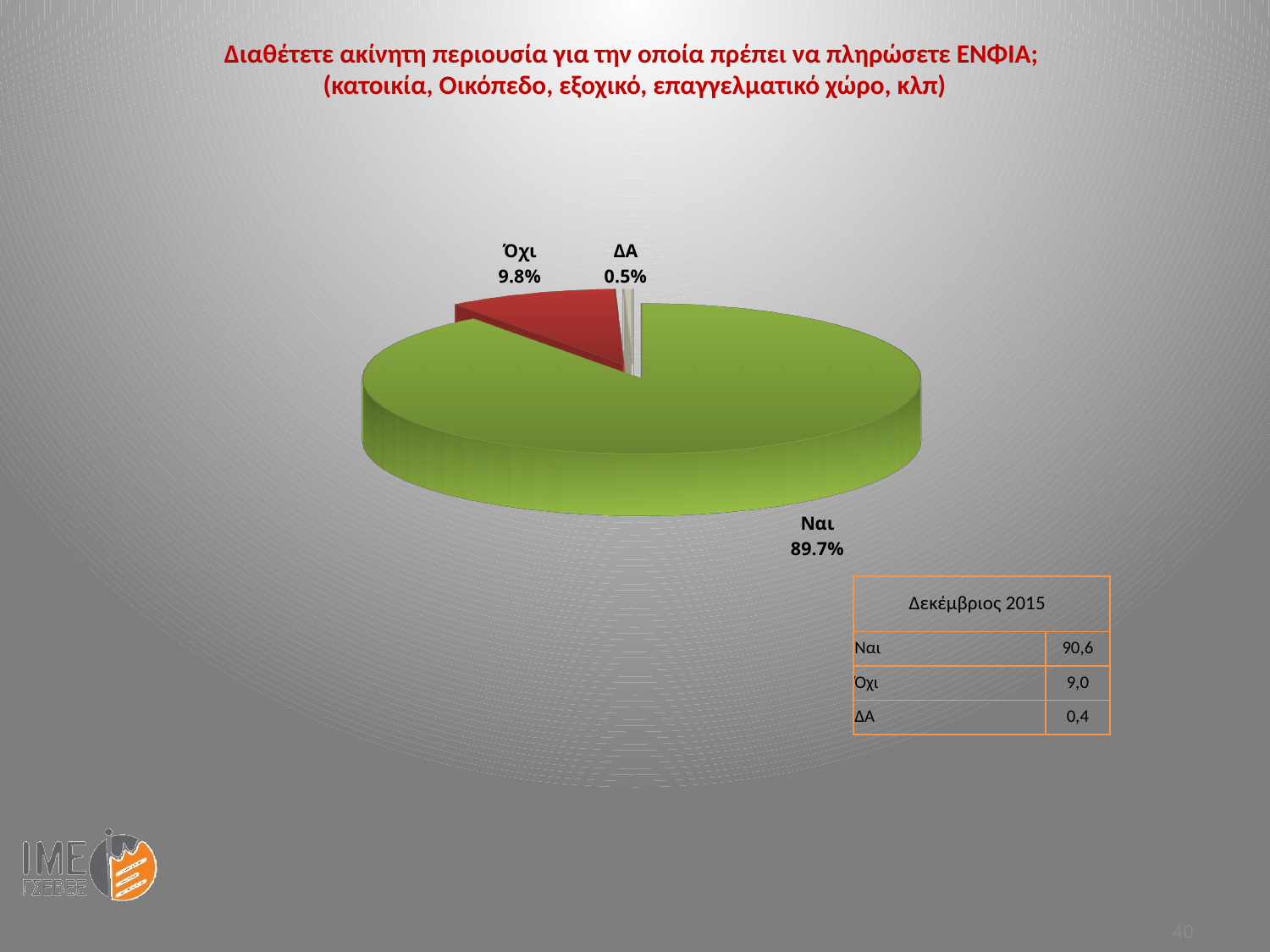
What colour is the "Όχι" slice of the pie chart? Red Which is larger in the pie chart, "Όχι" or "ΔΑ"? Όχι How many slices does the pie chart have? 3 What is the value shown for "ΔΑ" in the pie chart? 0.5% Which slice of the pie chart is the smallest? ΔΑ What is the value shown for "Όχι" in the pie chart? 9.8% Which slice of the pie chart is the largest? Ναι What kind of chart is shown on the slide? Pie chart What share of the pie does the "Ναι" slice represent? 89.7% What is the difference between the "Όχι" and "ΔΑ" shares in the pie chart? 9.3% What colour is the "Ναι" slice of the pie chart? Green What is the difference between the "Ναι" and "Όχι" shares in the pie chart? 79.9%